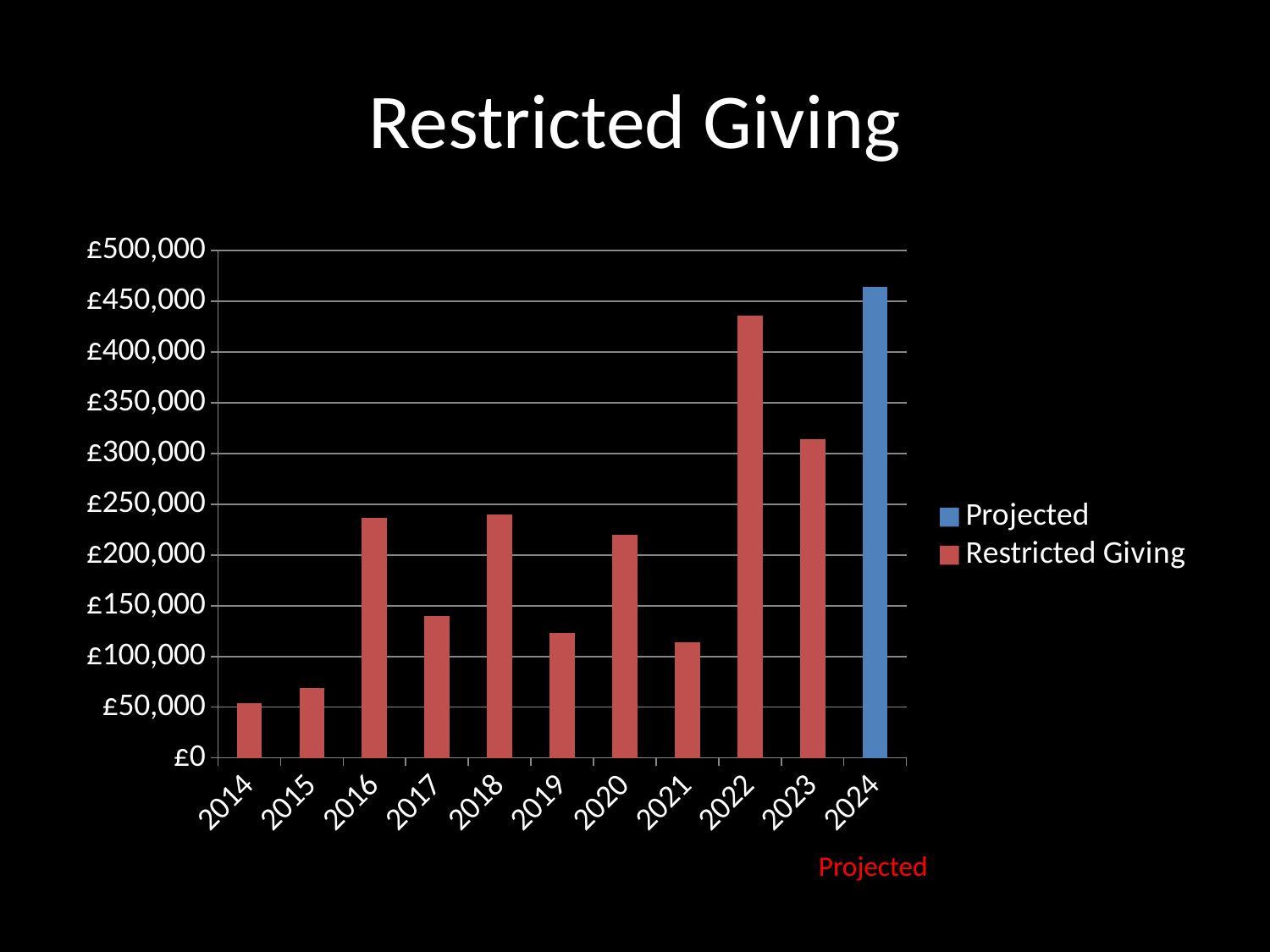
Is the value for 2024 greater or less than £450,000? greater How many years are shown on the x axis? 11 Is the value for 2014 greater or less than £100,000? less Which year has the highest value? 2024 What is the title of the chart? Restricted Giving Which is larger, the value for 2022 or the value for 2023? 2022 What type of chart is shown on the slide? bar chart Is the value for 2023 greater or less than £350,000? less Which year has the lowest value? 2014 Which series is shown in blue according to the legend? Projected How many series does the legend list? 2